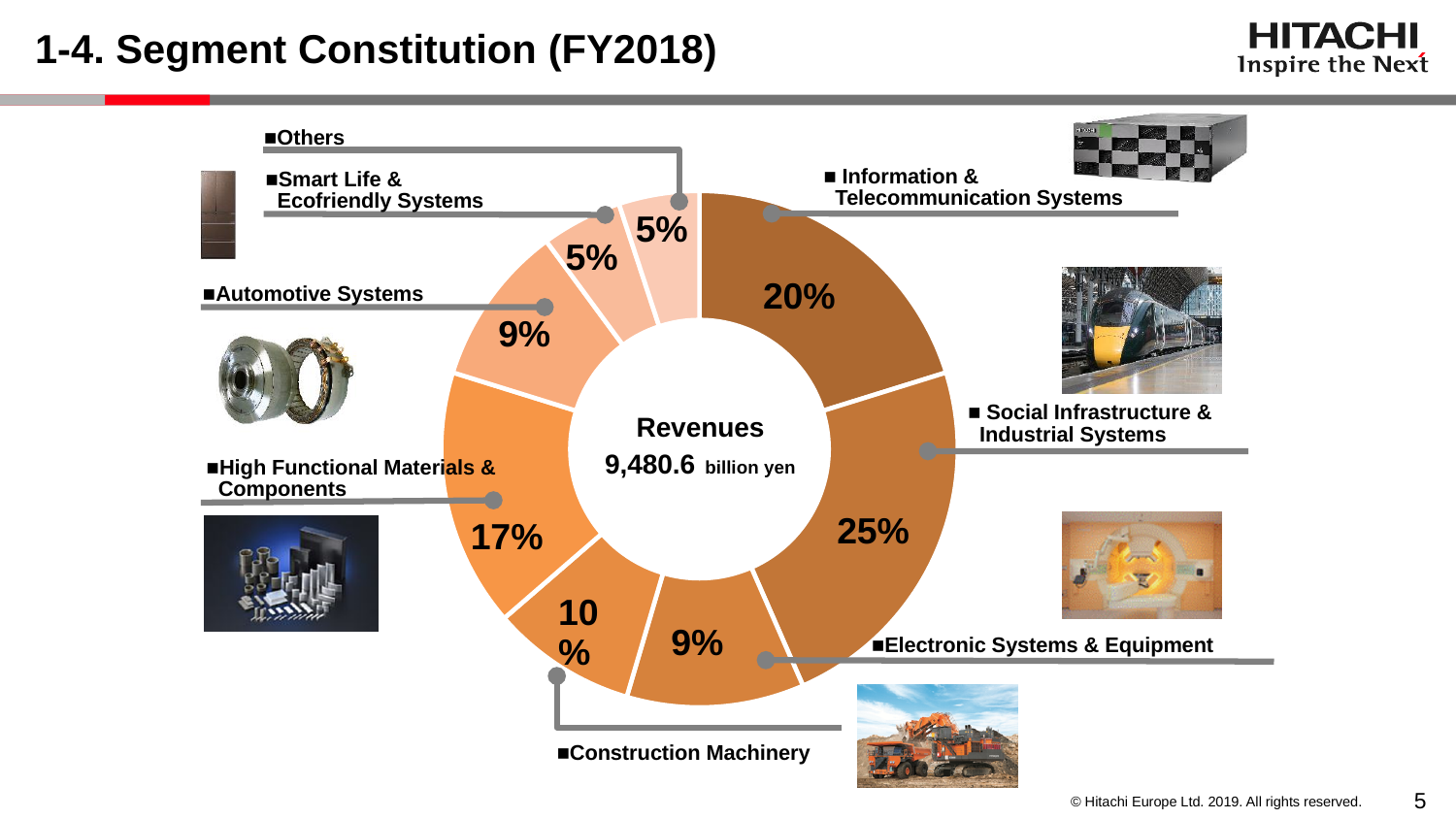
What share of revenues does Information & Telecommunication Systems account for? 20% What percentage is shown for High Functional Materials & Components? 17% What share of revenues does Social Infrastructure & Industrial Systems account for? 25% What total revenue figure is shown in the centre of the chart? 9,480.6 billion yen What is the difference in percentage points between Social Infrastructure & Industrial Systems and Information & Telecommunication Systems? 5 percentage points What kind of chart is shown on the slide? Pie (donut) chart What is the combined share of Smart Life & Ecofriendly Systems and Others? 10% What percentage is shown for Automotive Systems? 9% What percentage is shown for Construction Machinery? 10% How many segments are shown in the chart? 8 Which segment has the largest share of revenues? Social Infrastructure & Industrial Systems Which has a larger share: High Functional Materials & Components or Construction Machinery? High Functional Materials & Components